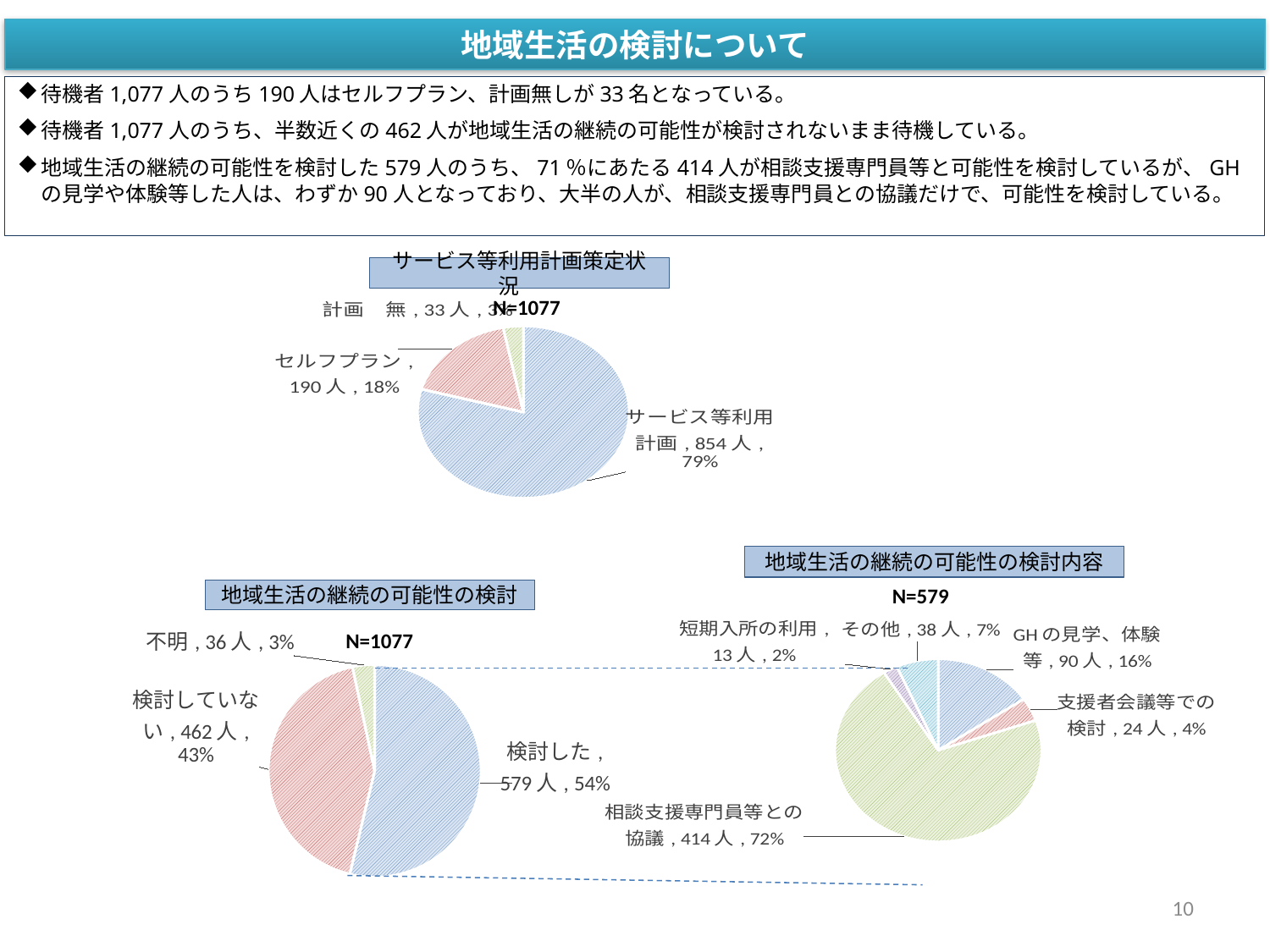
In the chart titled 「地域生活の継続の可能性の検討内容」, what percentage share does 「相談支援専門員等との協議」 have? 72% In the chart titled 「サービス等利用計画策定状況」, what percentage share does 「セルフプラン」 have? 18% In the chart titled 「地域生活の継続の可能性の検討」, how many categories are shown? 3 In the chart titled 「サービス等利用計画策定状況」, what is the difference in people between 「サービス等利用計画」 and 「セルフプラン」? 664人 In the chart titled 「サービス等利用計画策定状況」, which category is the smallest? 計画無 In the chart titled 「地域生活の継続の可能性の検討内容」, which is larger, 「GHの見学、体験等」 or 「その他」? GHの見学、体験等 In the chart titled 「サービス等利用計画策定状況」, how many people are in the 「サービス等利用計画」 slice? 854人 In the chart titled 「地域生活の継続の可能性の検討」, which category is the largest? 検討した In the chart titled 「地域生活の継続の可能性の検討内容」, how many categories are shown? 5 In the chart titled 「地域生活の継続の可能性の検討」, how many people are in the 「検討していない」 slice? 462人 In the chart titled 「地域生活の継続の可能性の検討内容」, what is the N value shown? N=579 What kind of chart is 「地域生活の継続の可能性の検討」? Pie chart